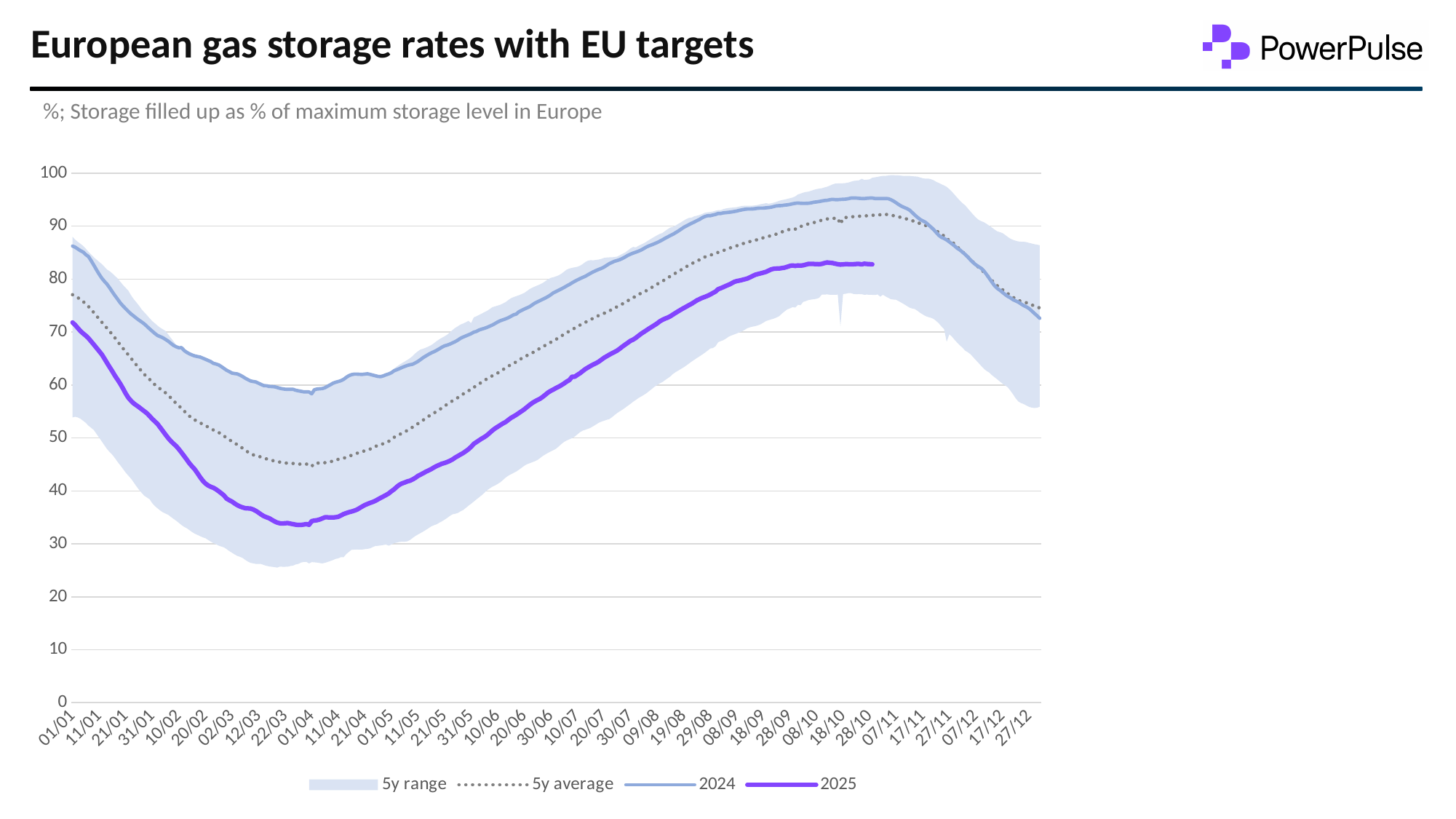
Is the value of the 2024 series on 28/10 greater or less than 90? greater How many entries does the legend list? 4 Is the value of the 2024 series on 27/12 greater or less than 80? less What kind of chart is shown on the slide? line chart On 22/03, which is higher, the 5y average or the 2025 series? 5y average What is the title of the chart? European gas storage rates with EU targets Does the 2025 series rise or fall between 01/04 and 28/10? rise On 01/01, which series has the higher value, 2024 or 2025? 2024 Is the value of the 2025 series on 22/03 greater or less than 40? less Which series is drawn as a dotted line? 5y average